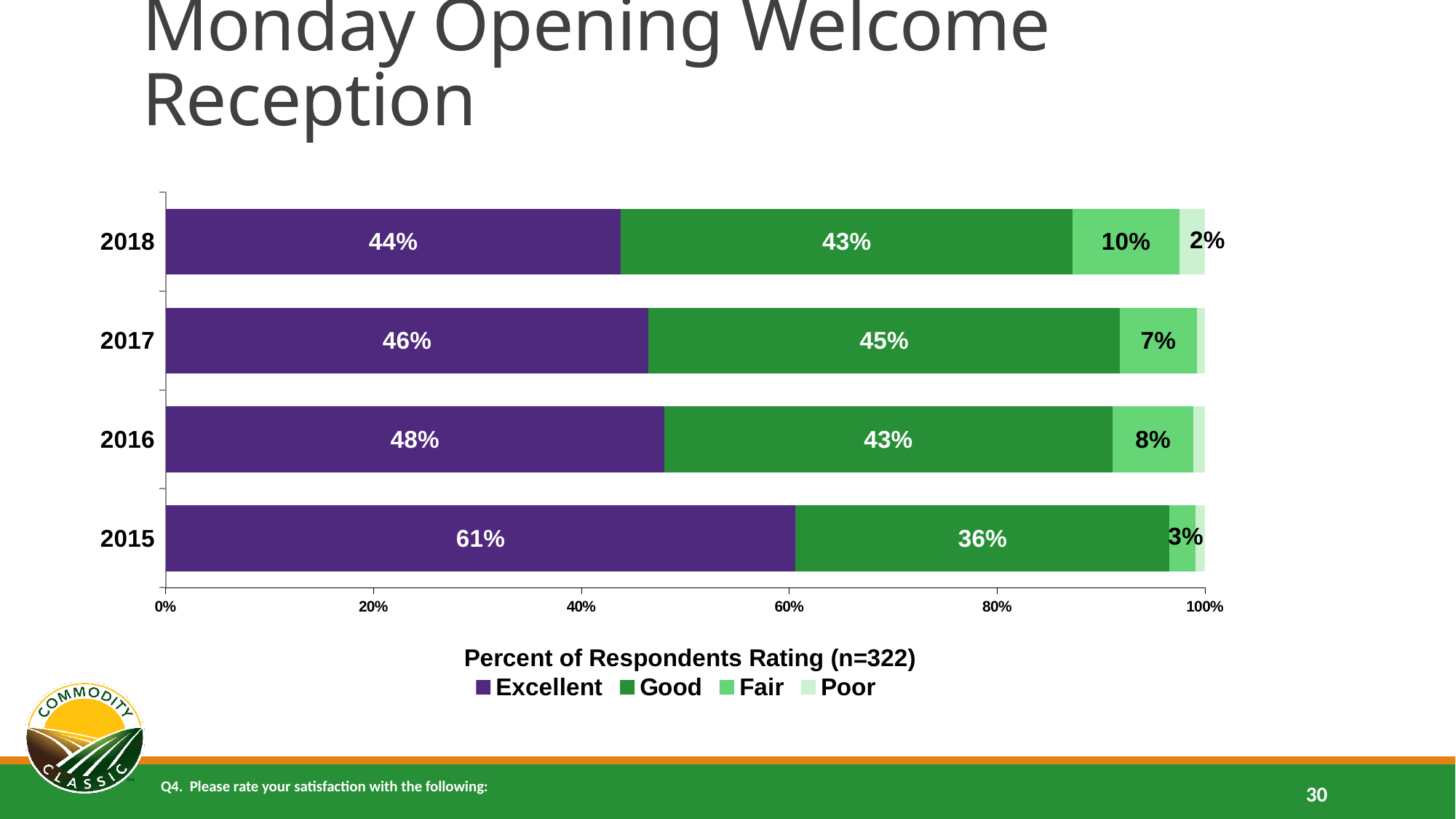
What type of chart is shown on the slide? Stacked bar chart How many rating categories does the legend list? 4 What is the sample size (n) given in the chart's axis title? 322 What percentage of respondents rated the reception as Poor in 2018? 2% What percentage of respondents rated the reception as Fair in 2016? 8% How many years are shown on the chart? 4 Which is larger, the Fair rating in 2018 or the Fair rating in 2017? 2018 What is the difference between the Excellent rating in 2015 and in 2018? 17 percentage points Which year had the lowest Good rating? 2015 Which year had the highest Excellent rating? 2015 What percentage of respondents rated the Monday Opening Welcome Reception as Excellent in 2018? 44% What percentage of respondents rated the reception as Good in 2017? 45%